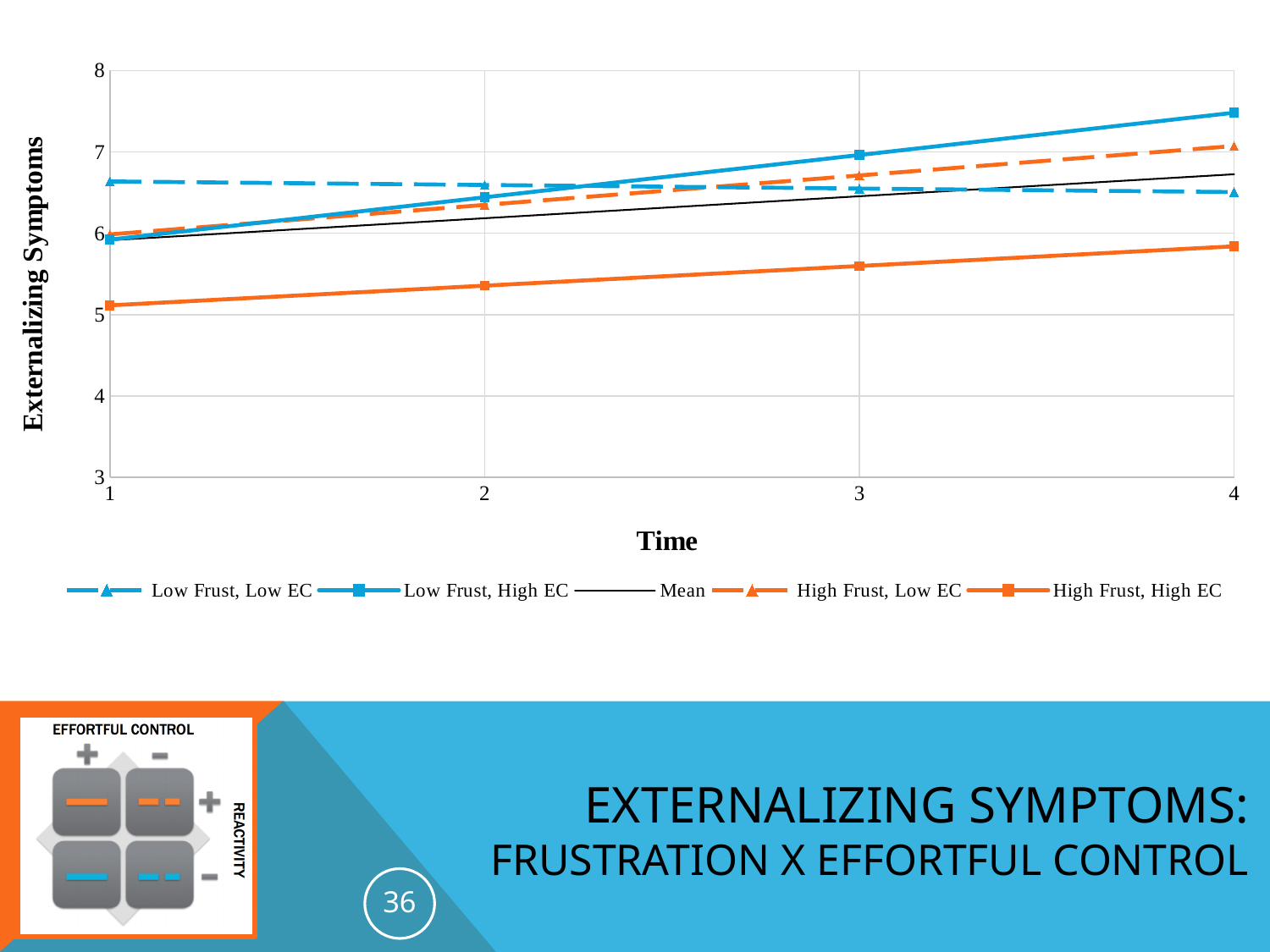
Which series has the lowest value at Time 1? High Frust, High EC Which series has the highest value at Time 4? Low Frust, High EC At Time 4, which is larger: Low Frust, High EC or High Frust, High EC? Low Frust, High EC Is the value for High Frust, High EC at Time 1 greater or less than 6? less Does the Low Frust, High EC line rise or fall from Time 1 to Time 4? rise How many time points are plotted along the x axis? 4 Is the value for High Frust, High EC at Time 4 greater or less than 6? less Is the value for Low Frust, High EC at Time 4 greater or less than 7? greater Does the Low Frust, Low EC line rise or fall from Time 1 to Time 4? fall What kind of chart is shown on the slide? line chart How many series does the legend list? 5 Does the High Frust, High EC line rise or fall from Time 1 to Time 4? rise